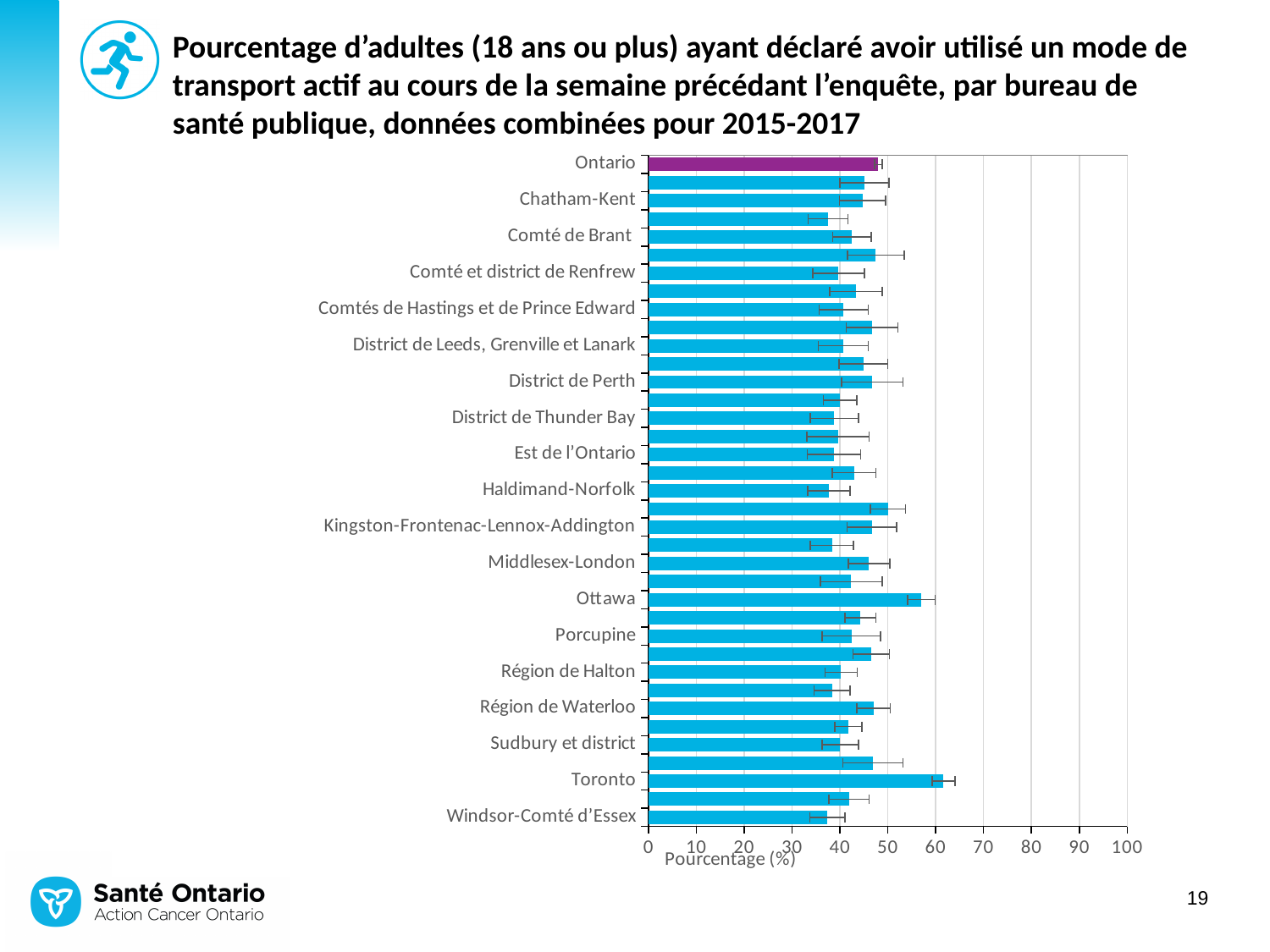
Which has the larger value, Toronto or Windsor-Comté d’Essex? Toronto Is the value for Haldimand-Norfolk greater or less than 40? less Is the value for Toronto greater or less than 50? greater Is the value for Comté de Brant greater or less than 50? less Which has the larger value, Toronto or Ottawa? Toronto What kind of chart is shown on the slide? bar chart Which bar is shown in a different colour (purple) from the others? Ontario What is the title of the horizontal axis? Pourcentage (%) Among the labelled public health units, which has the highest value? Toronto